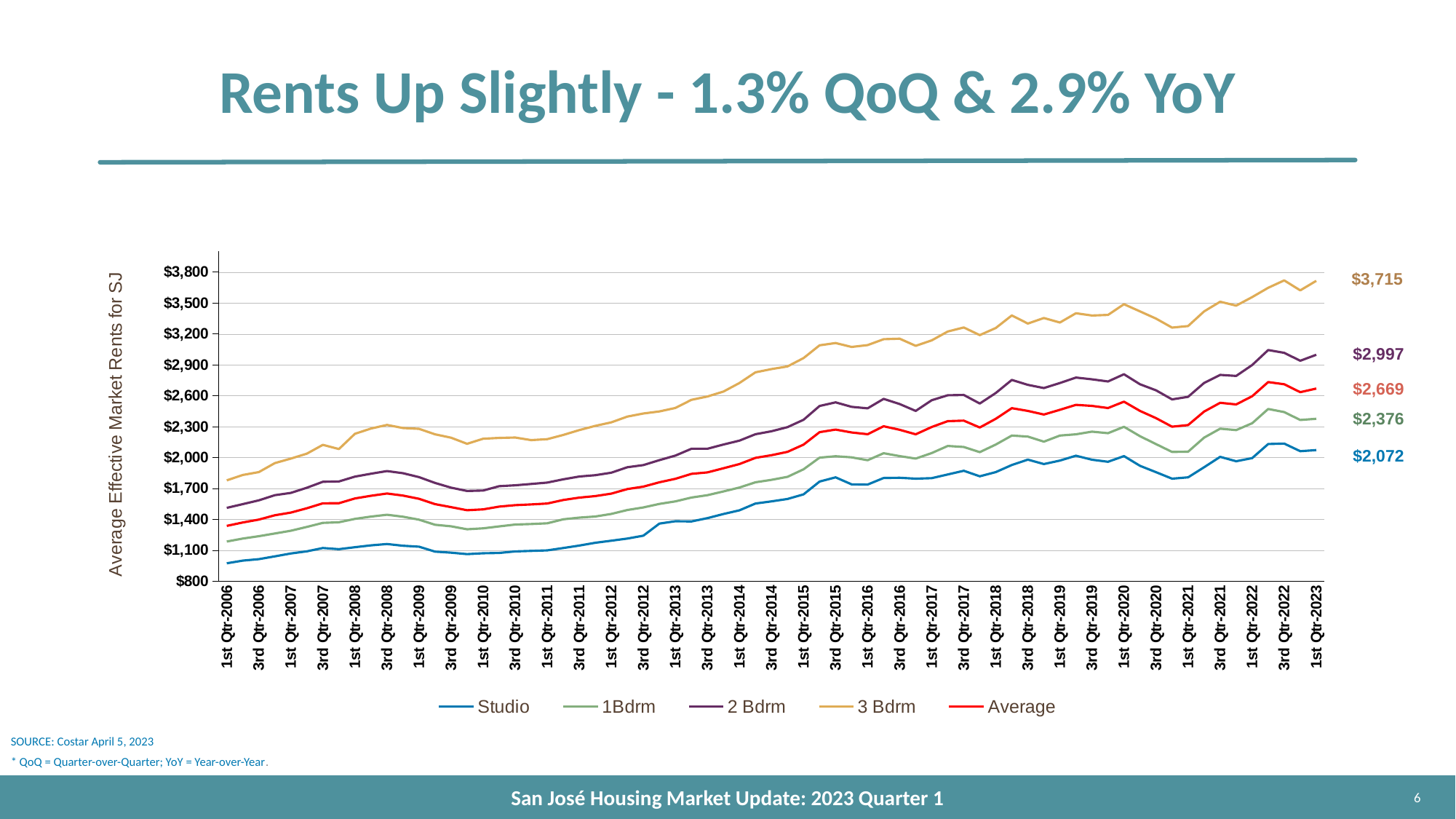
Which series has the highest value at 1st Qtr-2023? 3 Bdrm What kind of chart is shown on the slide? line chart What is the value for 3 Bdrm at 1st Qtr-2023? $3,715 What is the difference between the 2 Bdrm and 1Bdrm values at 1st Qtr-2023? $621 What is the difference between the 3 Bdrm and Studio values at 1st Qtr-2023? $1,643 What is the value for Studio at 1st Qtr-2023? $2,072 Is the value for Studio at 1st Qtr-2006 greater or less than $1,100? less Is the value for 3 Bdrm at 1st Qtr-2006 greater or less than $2,000? less How many series does the legend list? 5 Which series has the lowest value at 1st Qtr-2023? Studio At 1st Qtr-2023, which is larger: 2 Bdrm or Average? 2 Bdrm What is the value for Average at 1st Qtr-2023? $2,669